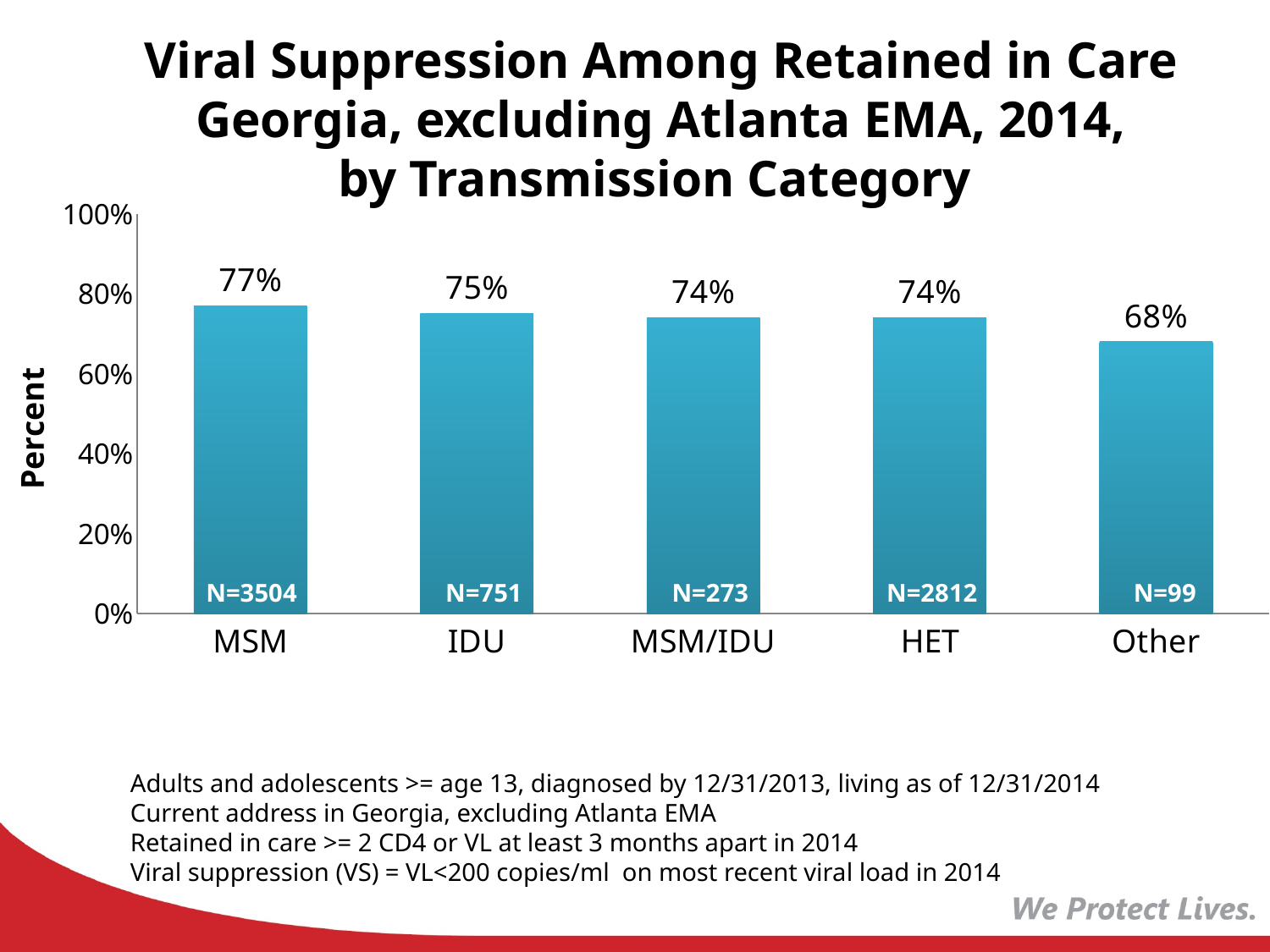
What is the viral suppression percentage for MSM? 77% What is the viral suppression percentage for IDU? 75% What is the difference in viral suppression percentage between IDU and HET? 1% What type of chart is shown on the slide? Bar chart Which has a higher viral suppression percentage, MSM or Other? MSM How many transmission categories are shown in the chart? 5 What is the N value shown on the HET bar? N=2812 What is the viral suppression percentage for the Other transmission category? 68% Which transmission category has the lowest viral suppression percentage? Other What is the difference in viral suppression percentage between MSM and Other? 9% Which transmission category has the highest viral suppression percentage? MSM What is the label on the vertical axis? Percent